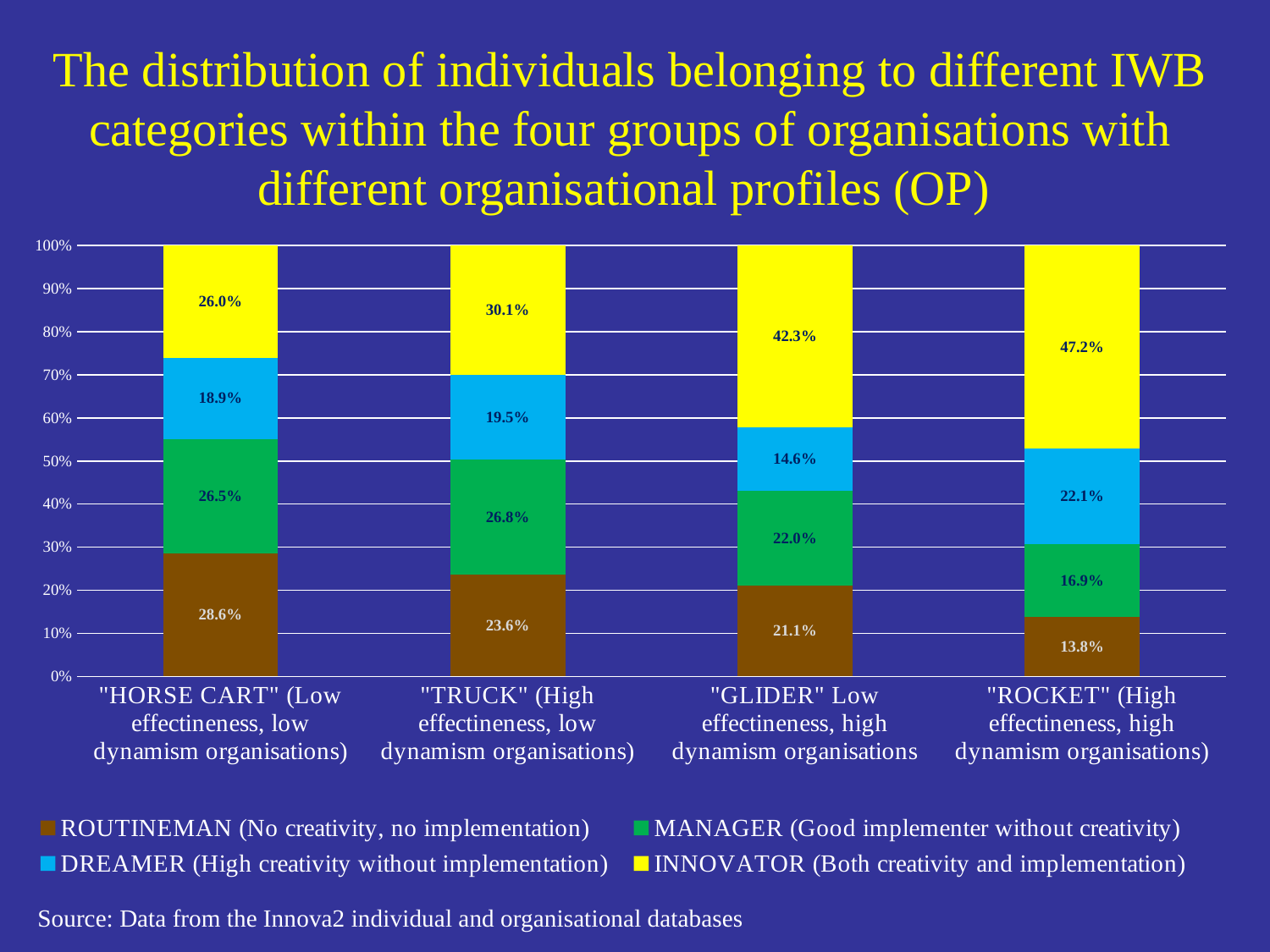
What is the MANAGER share for the "GLIDER" group? 22.0% Which group has the highest INNOVATOR share? "ROCKET" Which is larger: the DREAMER share for "GLIDER" or the DREAMER share for "ROCKET"? "ROCKET" What is the ROUTINEMAN share for the "HORSE CART" group? 28.6% Does the INNOVATOR share rise or fall from "HORSE CART" to "ROCKET"? Rise What is the difference between the INNOVATOR share of "ROCKET" and that of "HORSE CART"? 21.2% Which group has the lowest ROUTINEMAN share? "ROCKET" What is the DREAMER share for the "TRUCK" group? 19.5% What is the INNOVATOR share for the "ROCKET" group? 47.2% What kind of chart is shown? Stacked bar chart How many groups of organisations are shown on the x axis? 4 How many series does the legend list? 4